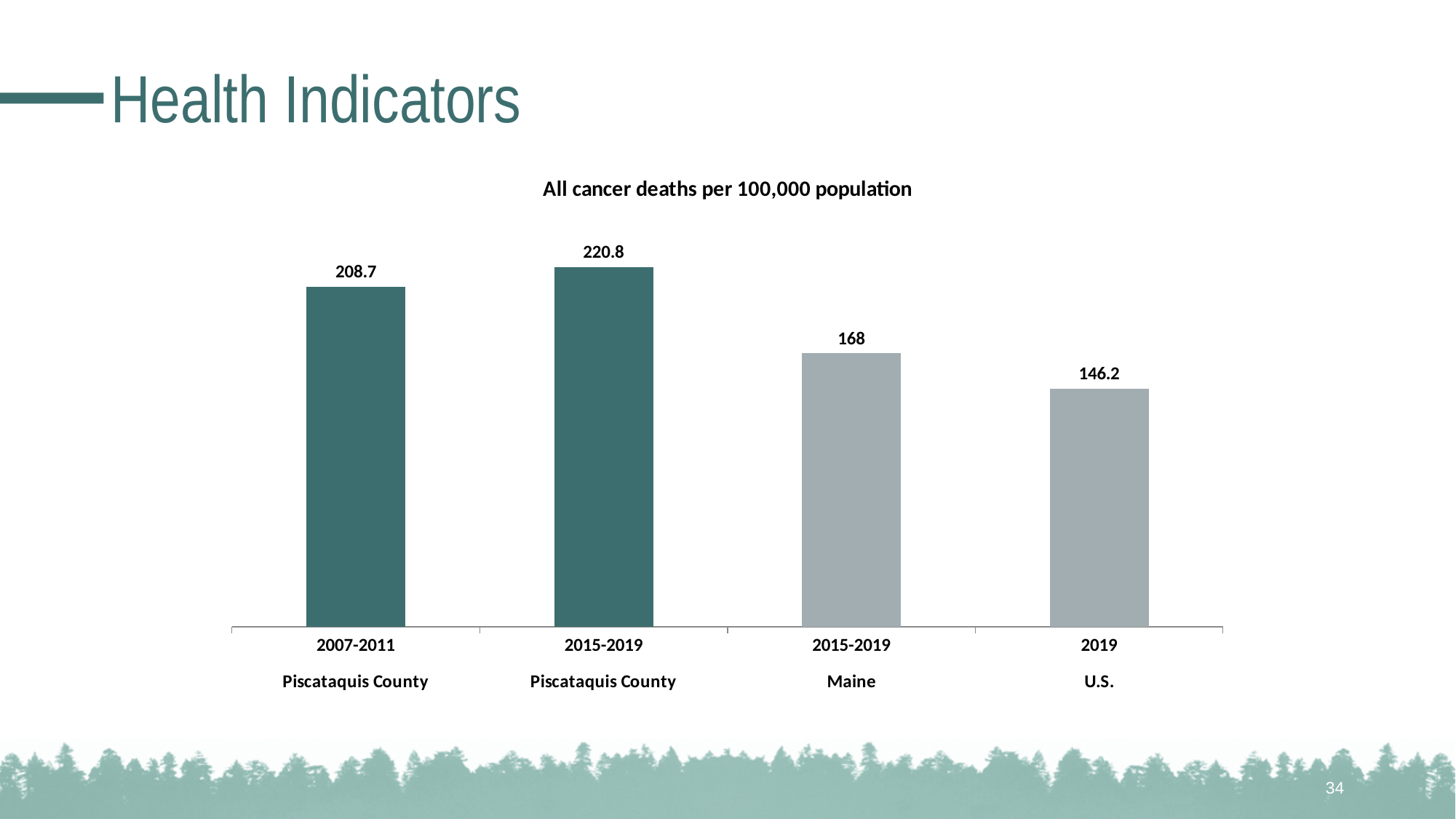
What is the title of the chart? All cancer deaths per 100,000 population What is the value for Piscataquis County in 2007-2011? 208.7 What is the difference between Piscataquis County 2015-2019 and Maine 2015-2019? 52.8 How many bars are shown in the chart? 4 Which category has the lowest value? U.S. 2019 Which is larger, the value for Maine 2015-2019 or the value for U.S. 2019? Maine 2015-2019 Which category has the highest value? Piscataquis County 2015-2019 What is the value for Piscataquis County in 2015-2019? 220.8 What kind of chart is shown on the slide? Bar chart What is the value for the U.S. in 2019? 146.2 What is the value for Maine in 2015-2019? 168 What is the difference between Piscataquis County 2015-2019 and Piscataquis County 2007-2011? 12.1